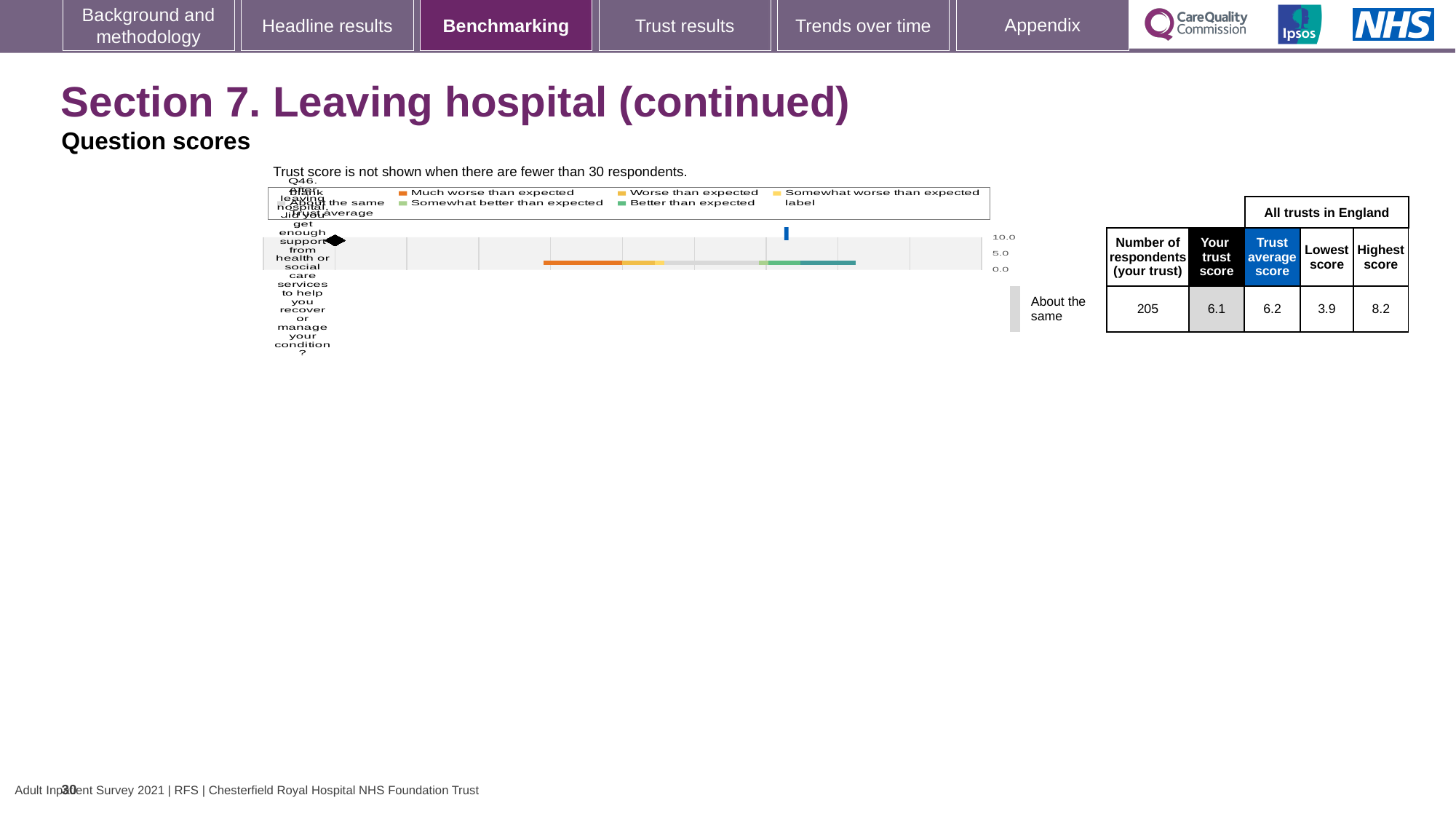
In the table beside the chart, what is the lowest score among all trusts in England for Q46? 3.9 According to the label next to the chart, how is the trust's result for Q46 categorised? About the same In the table beside the chart, what is the trust average score for Q46? 6.2 What is the highest value shown on the chart's axis? 10.0 What is the difference between the highest score and the lowest score for Q46 in the table beside the chart? 4.3 How many questions (categories) are plotted in the chart? 1 Is the trust score for Q46 larger or smaller than the trust average score? smaller In the table beside the chart, how many respondents answered Q46 for this trust? 205 In the table beside the chart, what is the trust score for Q46? 6.1 In the table beside the chart, what is the highest score among all trusts in England for Q46? 8.2 What kind of chart is shown on the slide? bar chart Which legend entry in the chart is shown in orange? Much worse than expected